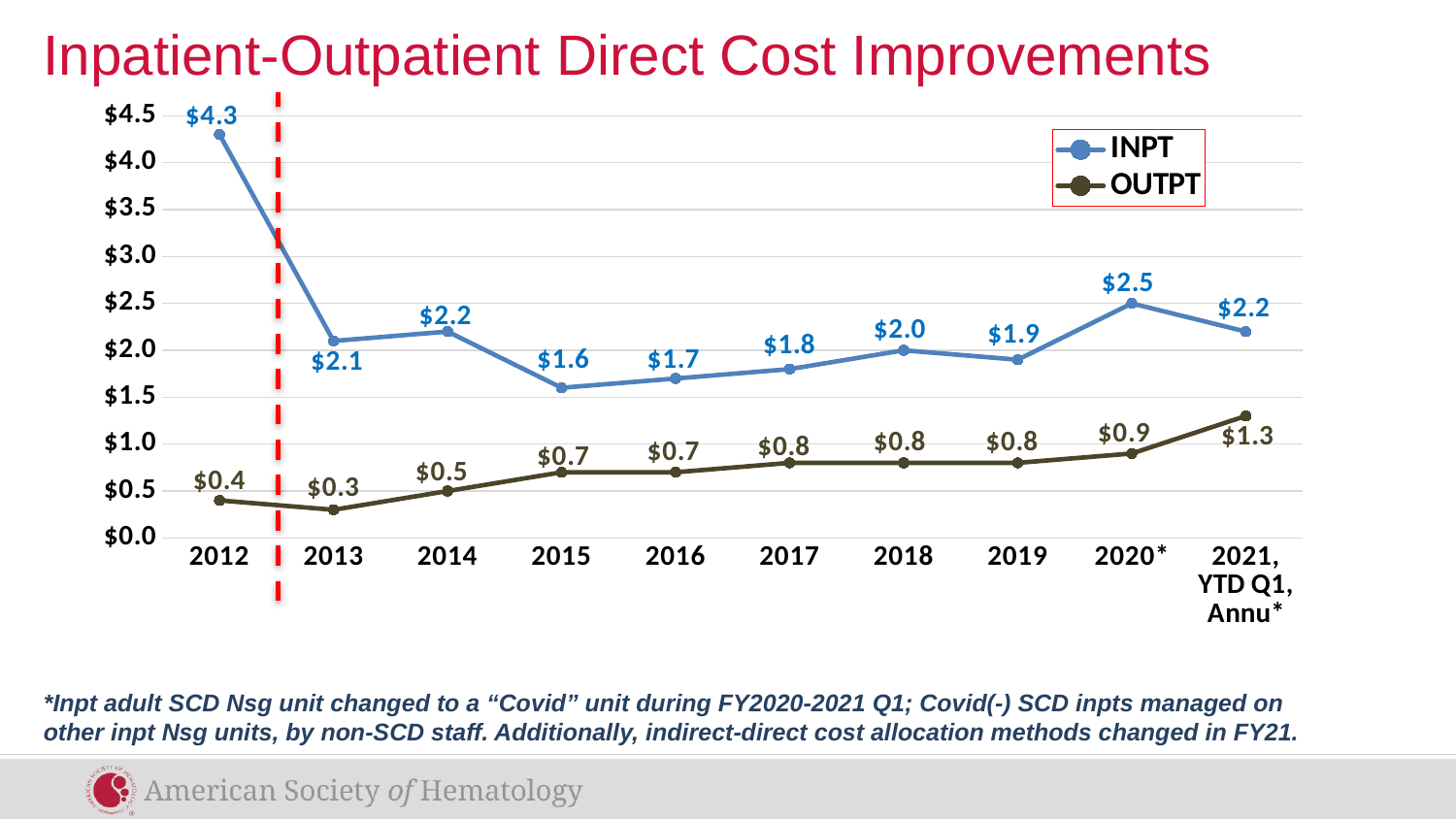
What is the OUTPT value for 2015? $0.7 Which year has the lowest INPT value? 2015 What is the difference between the INPT and OUTPT values in 2018? $1.2 Which year has the lowest OUTPT value? 2013 How many series does the legend list? 2 What is the INPT value for 2020*? $2.5 What is the INPT value for 2012? $4.3 Does the OUTPT series generally rise or fall from 2013 to 2021? Rise Which year has the highest INPT value? 2012 Is the INPT value for 2019 larger than the INPT value for 2020*? No What kind of chart is shown? Line chart How many years are shown on the x axis? 10